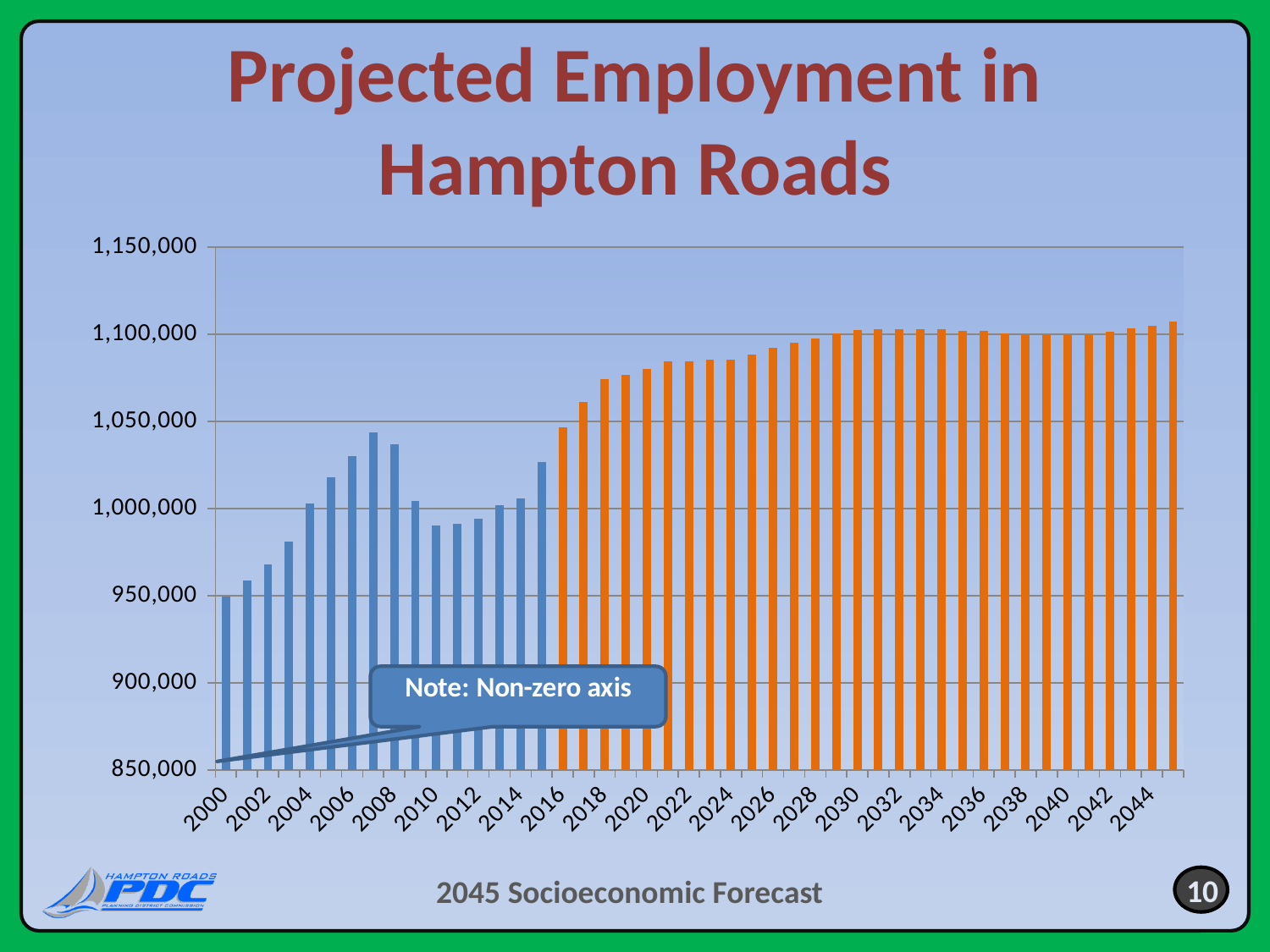
What does the note box on the chart say? Note: Non-zero axis Is the value for 2045 greater or less than 1,100,000? greater What is the title of the chart? Projected Employment in Hampton Roads Is the value for 2020 greater or less than 1,050,000? greater What kind of chart is shown on the slide? bar chart Which is larger, the value for 2005 or the value for 2010? 2005 Is the value for 2025 greater or less than 1,100,000? less Which is larger, the value for 2007 or the value for 2015? 2007 Which year has the lowest employment value in the chart? 2000 Which year has the highest employment value in the chart? 2045 Do the values generally rise or fall from 2016 to 2045? rise